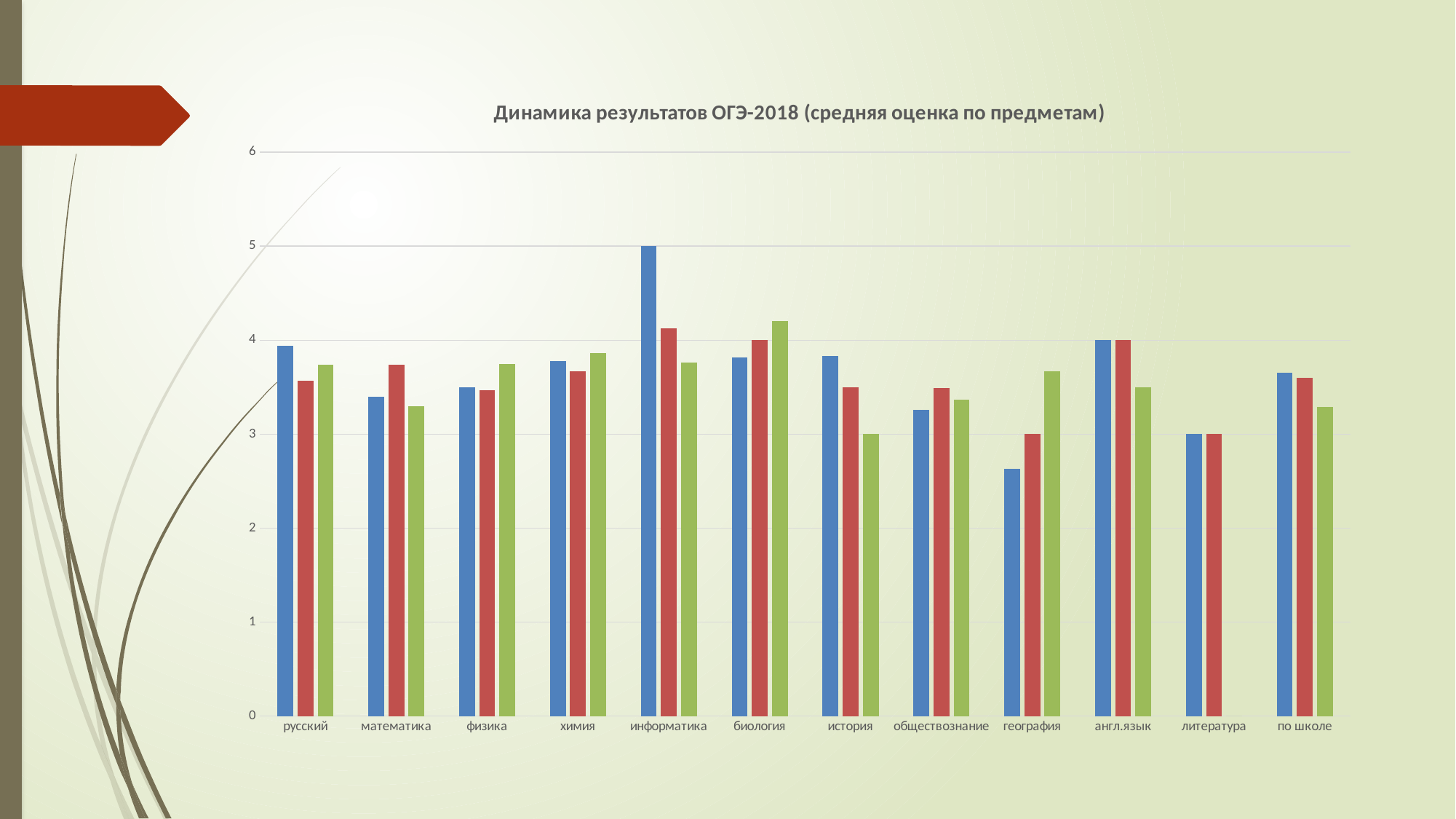
What is the value of the blue bar for информатика? 5 What kind of chart is shown on the slide? bar chart What is the value of the red bar for литература? 3 For информатика, which is larger: the blue bar or the green bar? the blue bar Is the value of the green bar for биология greater or less than 4? greater What is the title of the chart? Динамика результатов ОГЭ-2018 (средняя оценка по предметам) How many bars are shown for литература? 2 Which category has the highest bar in the chart? информатика Which category has the lowest bar in the chart? география Is the value of the blue bar for география greater or less than 3? less How many subject categories are shown along the x axis? 12 What is the value of the blue bar for англ.язык? 4